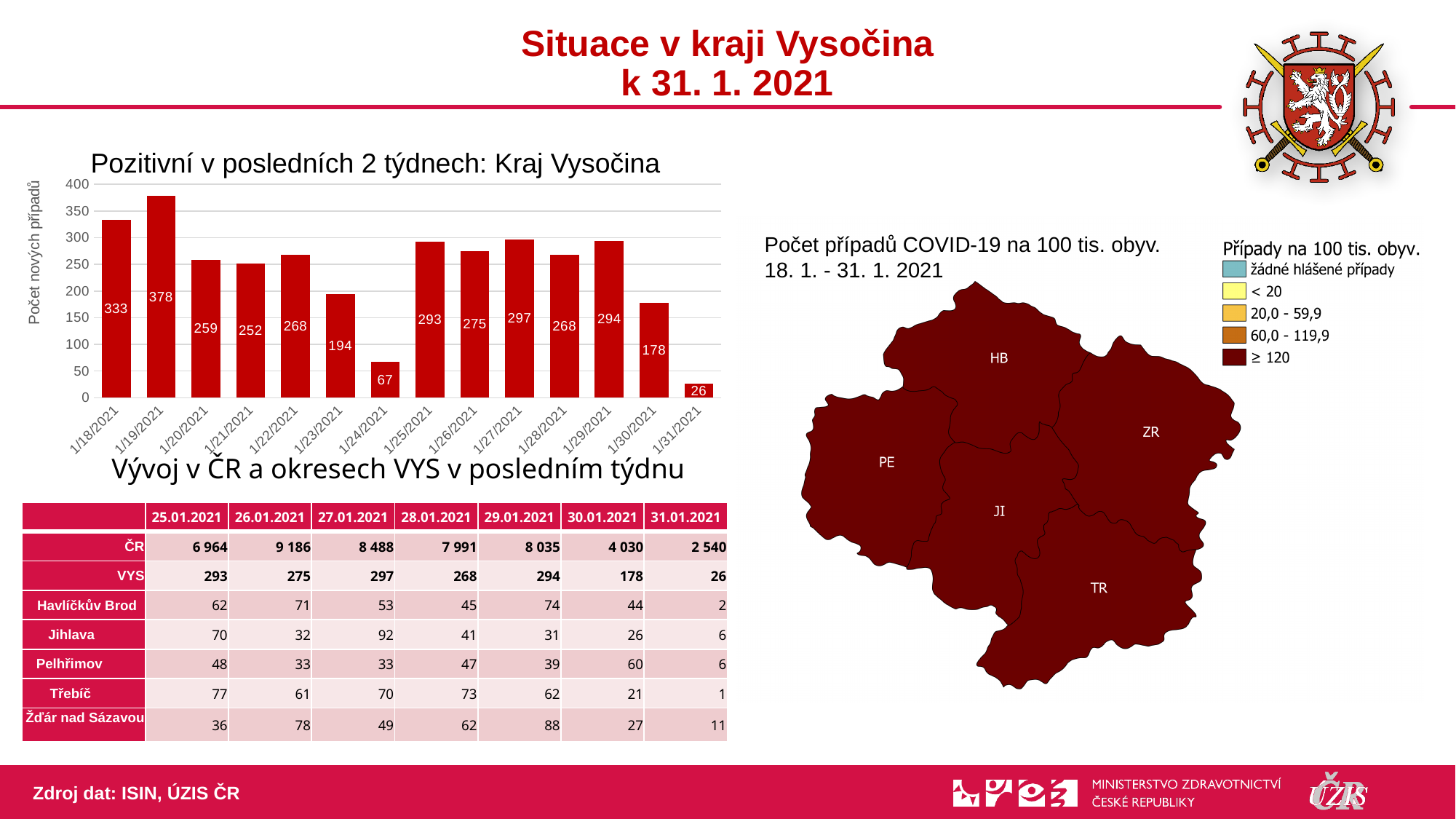
In the bar chart 'Pozitivní v posledních 2 týdnech: Kraj Vysočina', is the value for 1/25/2021 greater or less than 250? greater In the bar chart 'Pozitivní v posledních 2 týdnech: Kraj Vysočina', which date has the highest value? 1/19/2021 In the bar chart 'Pozitivní v posledních 2 týdnech: Kraj Vysočina', what is the value for 1/19/2021? 378 What kind of chart is 'Pozitivní v posledních 2 týdnech: Kraj Vysočina'? bar chart What is the y-axis label of the bar chart 'Pozitivní v posledních 2 týdnech: Kraj Vysočina'? Počet nových případů In the bar chart 'Pozitivní v posledních 2 týdnech: Kraj Vysočina', what is the value for 1/27/2021? 297 In the bar chart 'Pozitivní v posledních 2 týdnech: Kraj Vysočina', do the values rise or fall from 1/29/2021 to 1/31/2021? fall How many dates (bars) are shown in the bar chart 'Pozitivní v posledních 2 týdnech: Kraj Vysočina'? 14 In the bar chart 'Pozitivní v posledních 2 týdnech: Kraj Vysočina', what is the value for 1/24/2021? 67 In the bar chart 'Pozitivní v posledních 2 týdnech: Kraj Vysočina', which is larger, the value for 1/23/2021 or 1/30/2021? 1/23/2021 In the bar chart 'Pozitivní v posledních 2 týdnech: Kraj Vysočina', what is the difference between the values for 1/19/2021 and 1/18/2021? 45 In the bar chart 'Pozitivní v posledních 2 týdnech: Kraj Vysočina', which date has the lowest value? 1/31/2021